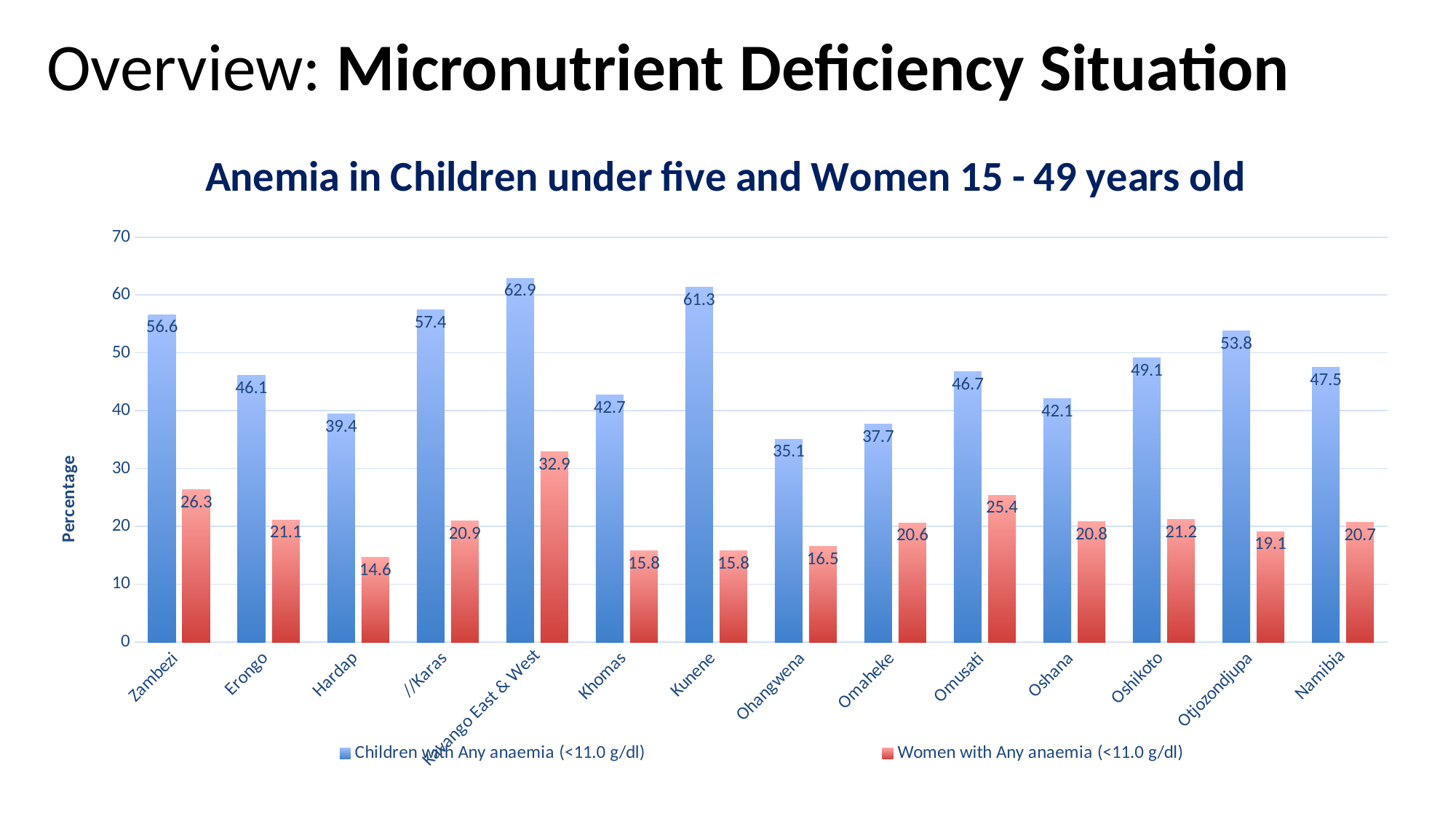
Which region has the lowest value for Children with Any anaemia? Ohangwena How many series does the legend list? 2 What is the value for Women with Any anaemia in Hardap? 14.6 What is the difference between the Children and Women anaemia values in Zambezi? 30.3 How many regions (categories) are shown on the x axis? 14 What kind of chart is shown on the slide? Bar chart What is the title of the chart? Anemia in Children under five and Women 15 - 49 years old What is the value for Children with Any anaemia in Namibia? 47.5 Which region has the lowest value for Women with Any anaemia? Hardap Which region has the highest value for Children with Any anaemia? Kavango East & West Which is larger: the Children with Any anaemia value for Oshikoto or for Oshana? Oshikoto What is the value for Children with Any anaemia in Kunene? 61.3